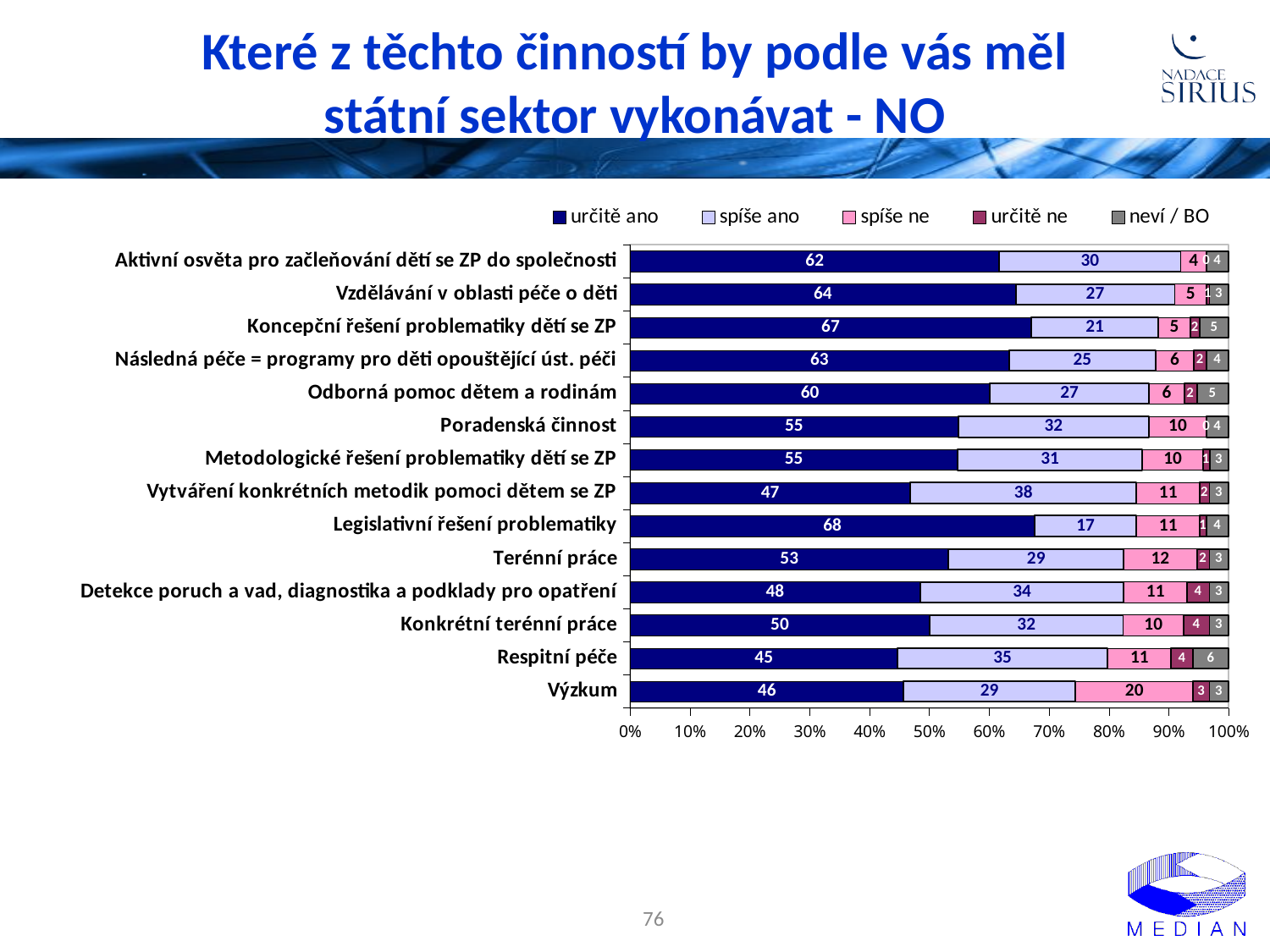
Which category has the highest 'určitě ano' value? Legislativní řešení problematiky How many categories (activities) are plotted on the chart? 14 What type of chart is shown on the slide? stacked bar chart What is the 'určitě ano' value for 'Legislativní řešení problematiky'? 68 How many series does the legend list? 5 Which has a larger 'spíše ano' value: 'Poradenská činnost' or 'Koncepční řešení problematiky dětí se ZP'? Poradenská činnost What is the difference between the 'určitě ano' values for 'Koncepční řešení problematiky dětí se ZP' and 'Terénní práce'? 14 What is the last entry in the chart legend? neví / BO What is the 'spíše ne' value for 'Výzkum'? 20 What is the 'spíše ano' value for 'Vytváření konkrétních metodik pomoci dětem se ZP'? 38 Which category has the lowest 'určitě ano' value? Respitní péče Which category has the highest 'spíše ne' value? Výzkum